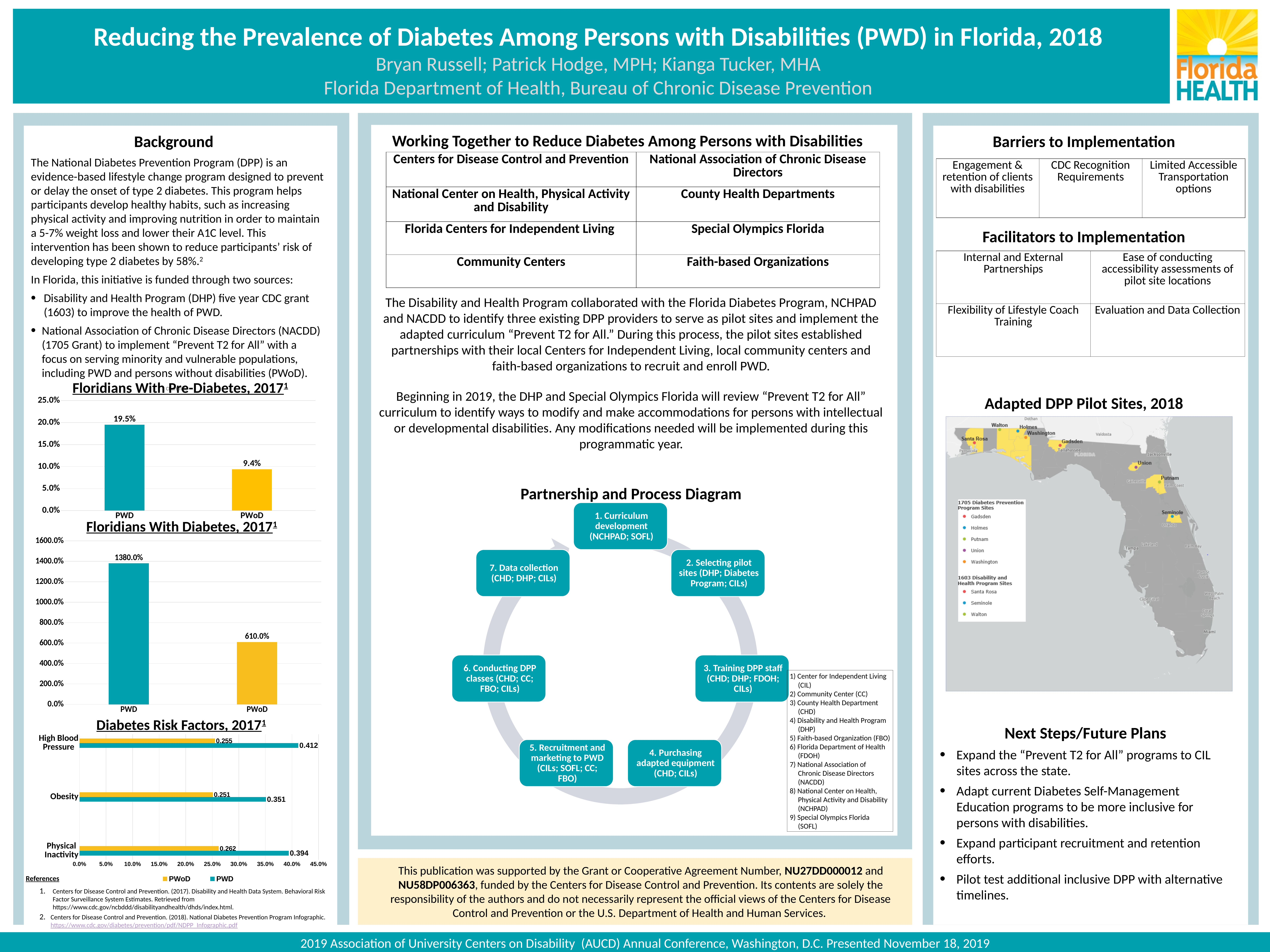
In the 'Floridians With Pre-Diabetes, 2017' chart, what is the value for PWD? 19.5% In the 'Diabetes Risk Factors, 2017' chart, what is the PWD value for High Blood Pressure? 0.412 In the 'Diabetes Risk Factors, 2017' chart, what is the PWD value for Physical Inactivity? 0.394 In the 'Floridians With Diabetes, 2017' chart, which category has the higher value? PWD What kind of chart is 'Diabetes Risk Factors, 2017'? Bar chart In the 'Floridians With Diabetes, 2017' chart, what is the value labelled for PWoD? 610.0% In the 'Floridians With Diabetes, 2017' chart, what is the value labelled for PWD? 1380.0% In the 'Diabetes Risk Factors, 2017' chart, how many series does the legend list? 2 In the 'Diabetes Risk Factors, 2017' chart, which risk factor has the lowest PWD value? Obesity In the 'Floridians With Pre-Diabetes, 2017' chart, what is the difference between the PWD and PWoD values? 10.1% In the 'Floridians With Pre-Diabetes, 2017' chart, what is the value for PWoD? 9.4% In the 'Diabetes Risk Factors, 2017' chart, what is the PWoD value for Obesity? 0.251